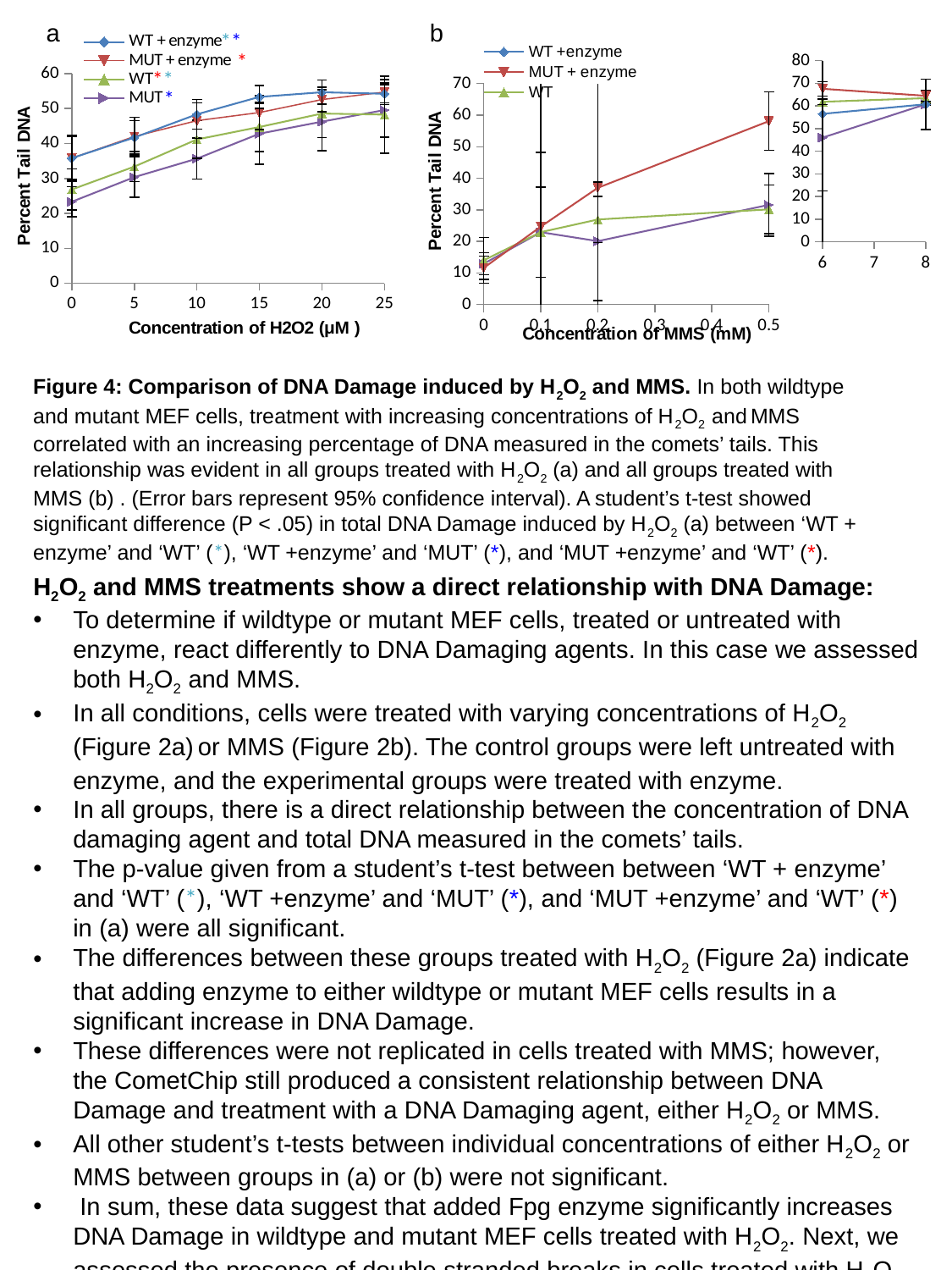
How many series does the legend of chart a (Concentration of H2O2) list? 4 How many series does the legend of chart b (Concentration of MMS) list? 3 What kind of chart is chart a (Concentration of H2O2)? line chart In chart b (Concentration of MMS), is the value for MUT + enzyme at 0.2 mM greater or less than 30? greater In chart b (Concentration of MMS), is the value for WT at 0.5 mM greater or less than 40? less In chart b (Concentration of MMS), is the value for MUT + enzyme at 0.5 mM greater or less than 50? greater In chart b (Concentration of MMS), which series has the highest value at 0.5 mM? MUT + enzyme How many concentration points are plotted for each series in chart a (Concentration of H2O2)? 6 In chart a (Concentration of H2O2), does the WT + enzyme series rise or fall as concentration increases? rise What is the y-axis title of chart a? Percent Tail DNA